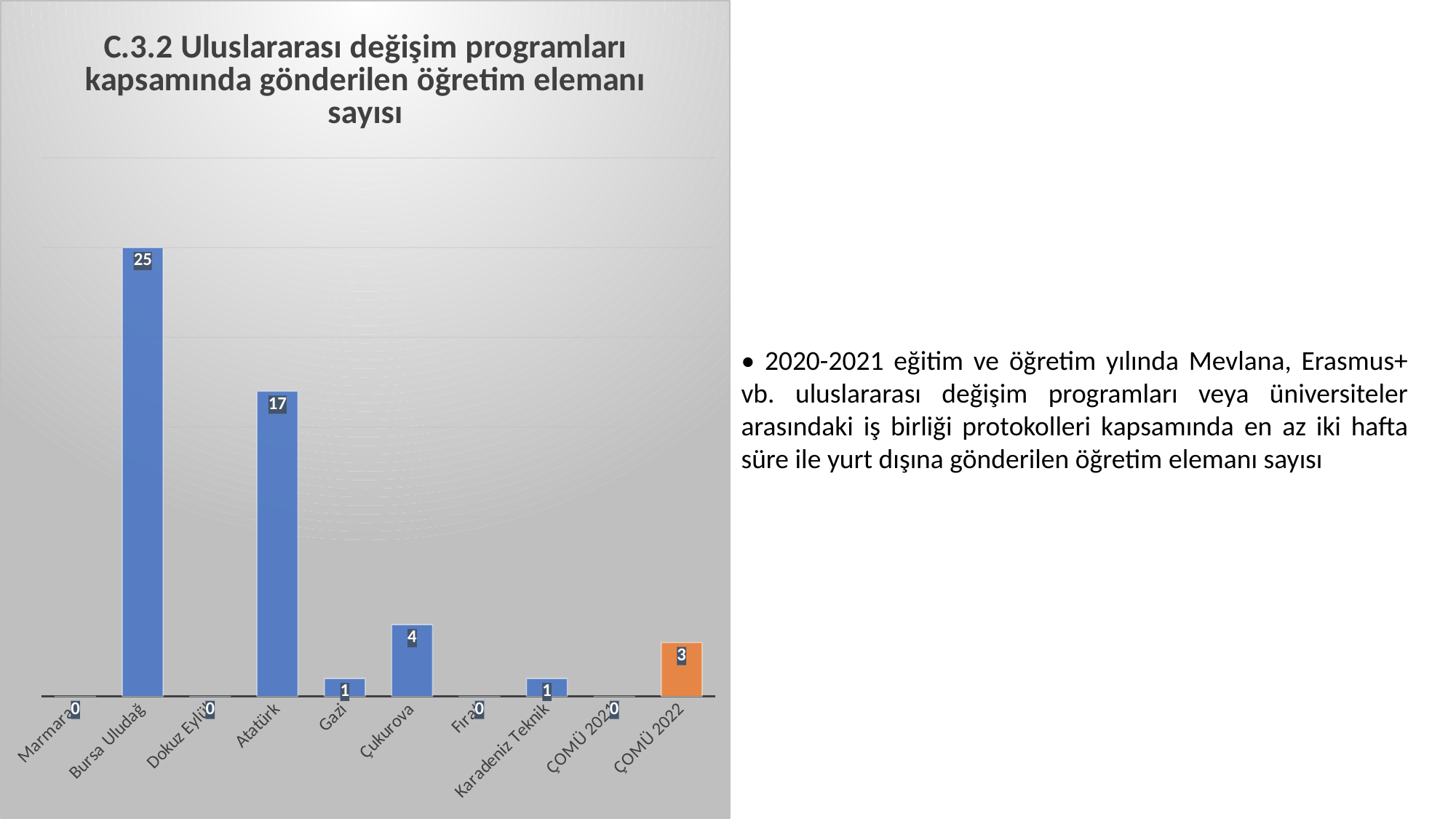
What is the value for Atatürk? 17 What kind of chart is shown on the slide? Bar chart How many categories are shown on the x axis? 10 What is the value for Bursa Uludağ? 25 Which category has the highest value? Bursa Uludağ What is the value for Karadeniz Teknik? 1 Which is larger, the value for Çukurova or the value for ÇOMÜ 2022? Çukurova What is the value for ÇOMÜ 2022? 3 What is the difference between the values for Bursa Uludağ and Atatürk? 8 Which category's bar is coloured orange instead of blue? ÇOMÜ 2022 What is the value for Çukurova? 4